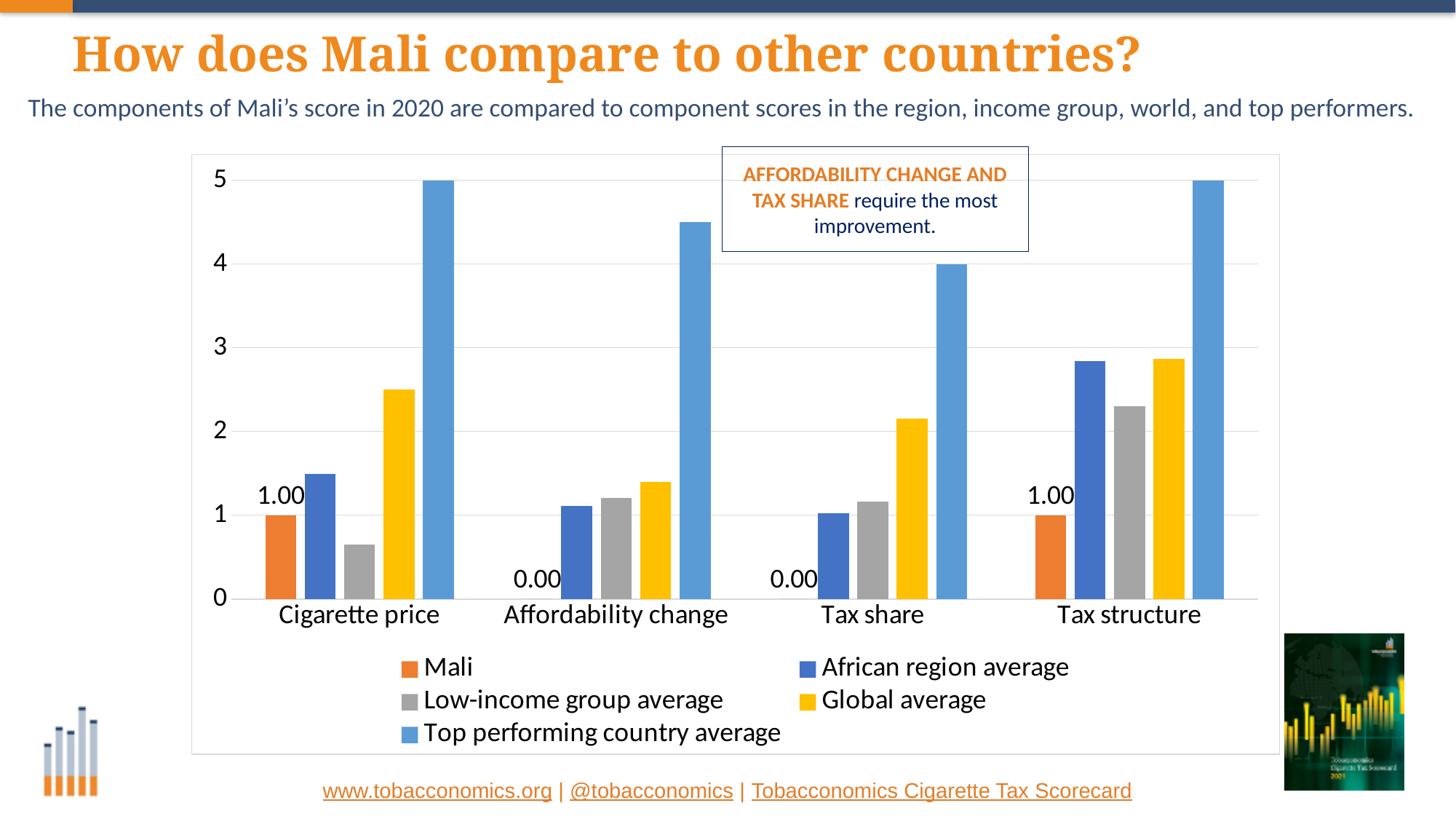
Which series has the highest value for Tax structure? Top performing country average What is Mali's value for Cigarette price? 1.00 What is the Top performing country average value for Cigarette price? 5 Which series has the lowest value for Tax share? Mali What is the Top performing country average value for Tax share? 4 How many series does the legend list? 5 What is Mali's value for Affordability change? 0.00 Is the Low-income group average value for Cigarette price greater or less than 1? less Is the Global average value for Cigarette price greater or less than 2? greater How many categories are shown on the x axis? 4 What is Mali's value for Tax structure? 1.00 Which is larger for Cigarette price: the African region average or the Low-income group average? African region average